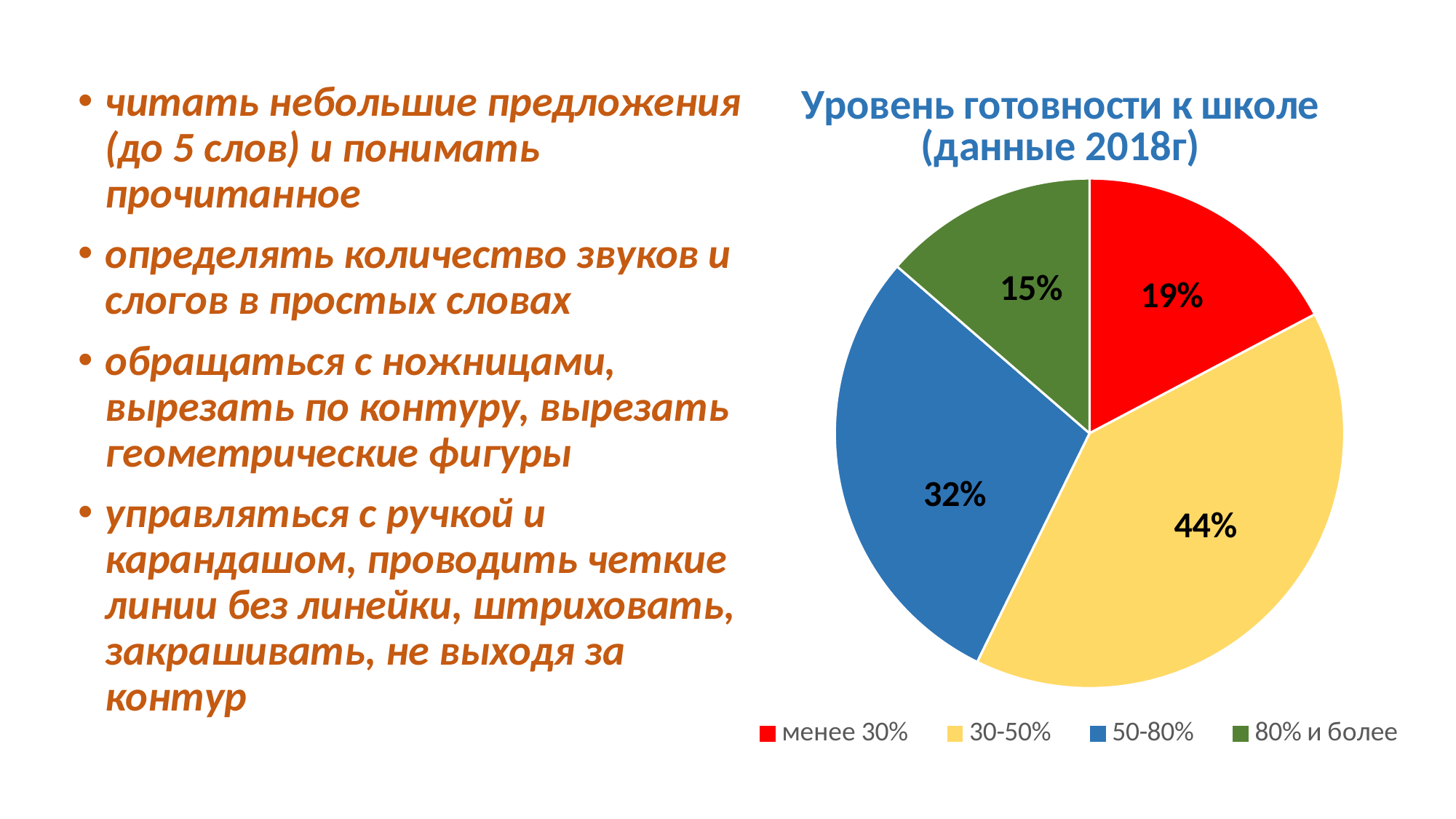
What is the difference between the "30-50%" slice and the "50-80%" slice? 12% What share of the pie does the "менее 30%" slice represent? 19% What kind of chart is shown on the slide? pie chart What colour is the "50-80%" slice? blue What share of the pie does the "80% и более" slice represent? 15% What share of the pie does the "50-80%" slice represent? 32% What share of the pie does the "30-50%" slice represent? 44% What is the title of the chart? Уровень готовности к школе (данные 2018г) How many slices does the pie chart have? 4 Which category has the smallest slice of the pie? 80% и более Which category has the largest slice of the pie? 30-50% Which slice is larger: "менее 30%" or "80% и более"? менее 30%